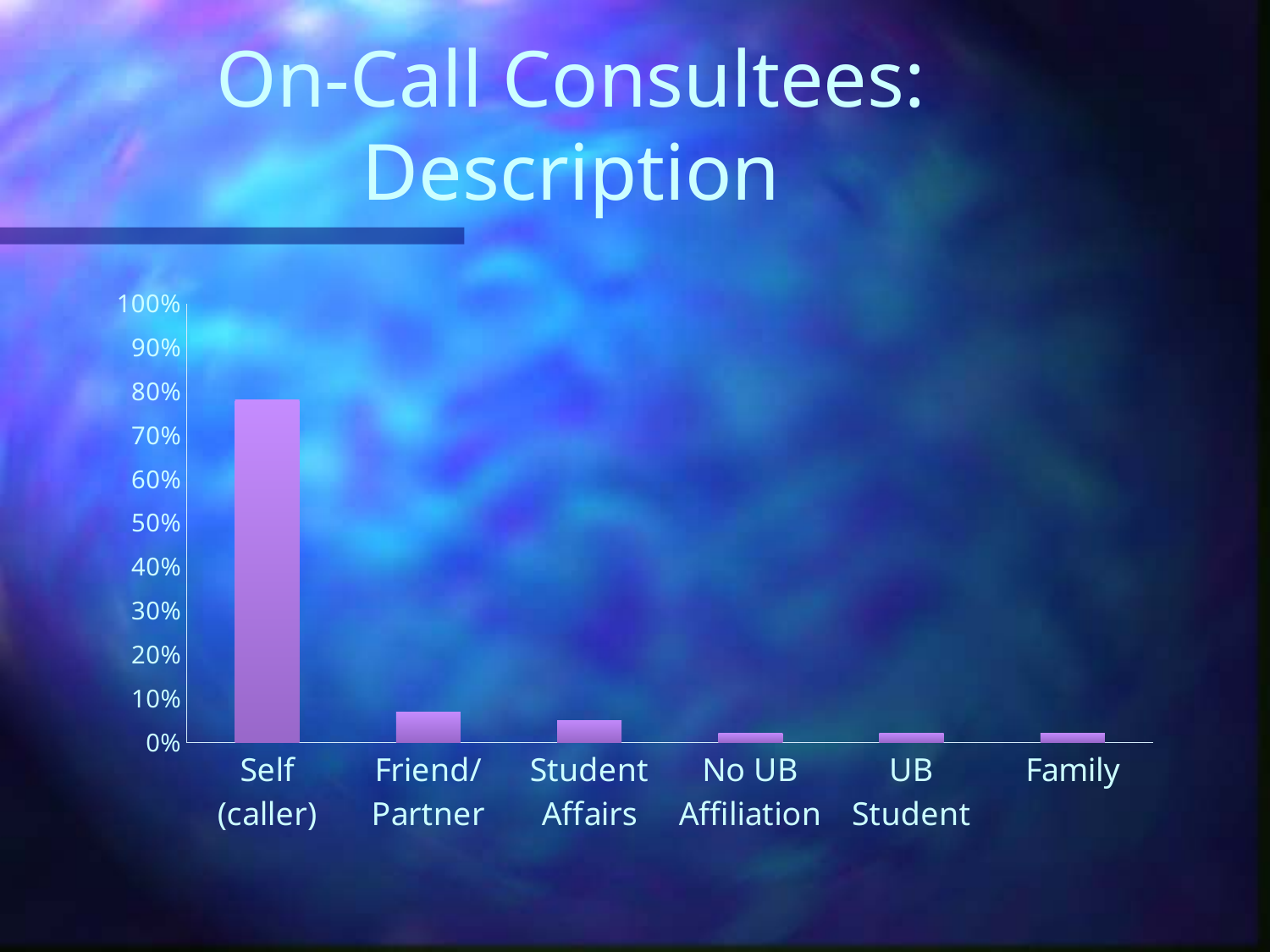
What kind of chart is shown on the slide? bar chart What is the title of the slide containing the chart? On-Call Consultees: Description Which is larger, the value for Friend/Partner or the value for Student Affairs? Friend/Partner Which is larger, the value for Self (caller) or the value for Friend/Partner? Self (caller) Is the value for Self (caller) greater or less than 80%? less Is the value for Family greater or less than 10%? less Which category has the highest value in the chart? Self (caller) What is the highest value shown on the chart's y axis? 100% Is the value for Friend/Partner greater or less than 10%? less How many categories are shown on the x axis of the chart? 6